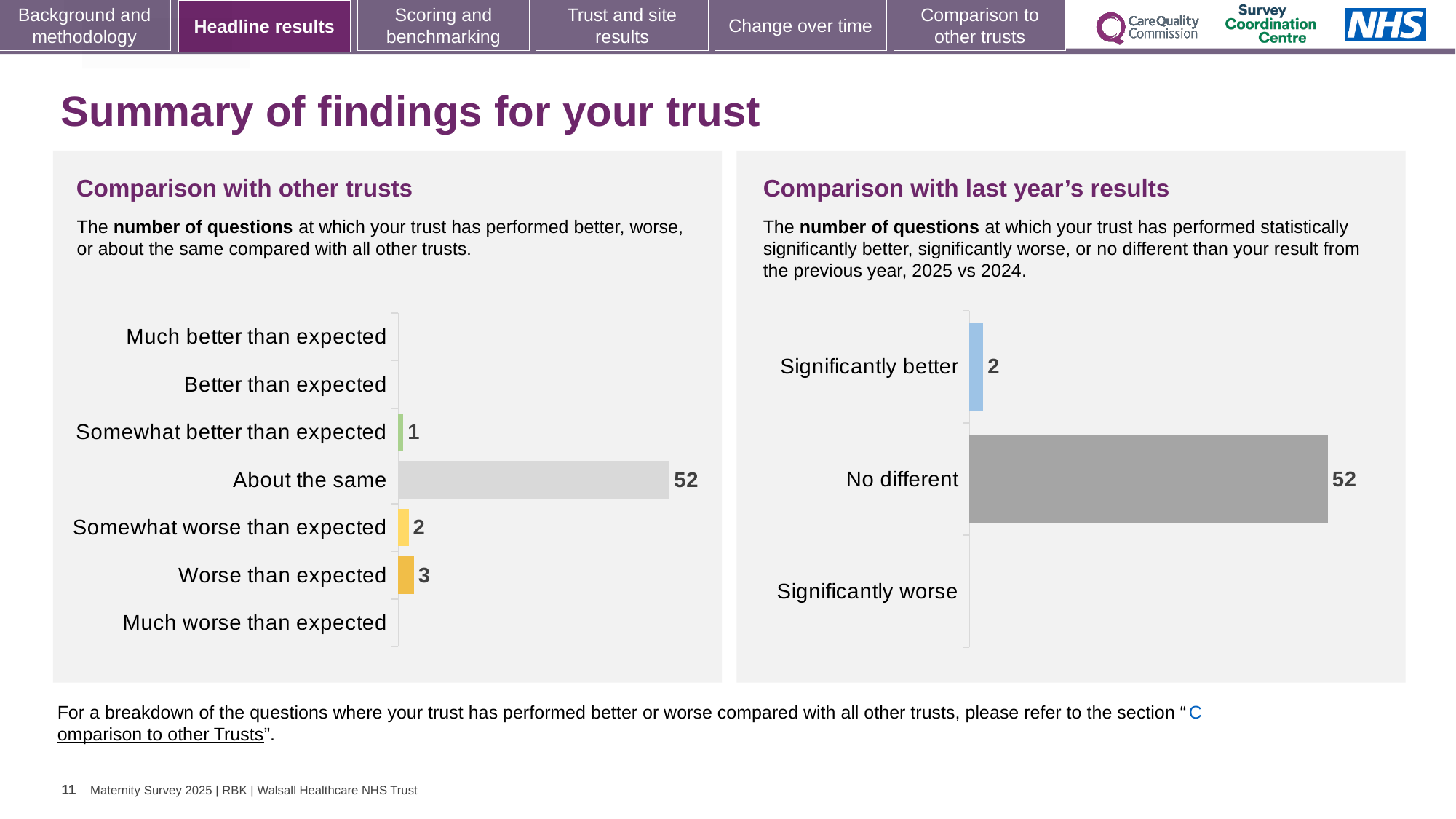
In the 'Comparison with last year's results' chart, what is the value for 'No different'? 52 In the 'Comparison with other trusts' chart, which category has the highest value? About the same In the 'Comparison with other trusts' chart, what is the value for 'Somewhat worse than expected'? 2 In the 'Comparison with other trusts' chart, which is larger: 'Worse than expected' or 'Somewhat worse than expected'? Worse than expected In the 'Comparison with other trusts' chart, what is the value for 'Worse than expected'? 3 In the 'Comparison with other trusts' chart, what is the difference between 'About the same' and 'Worse than expected'? 49 In the 'Comparison with other trusts' chart, what is the value for 'About the same'? 52 In the 'Comparison with last year's results' chart, what is the value for 'Significantly better'? 2 In the 'Comparison with other trusts' chart, what is the value for 'Somewhat better than expected'? 1 What kind of chart is the 'Comparison with last year's results' chart? Bar chart How many categories are listed on the 'Comparison with other trusts' chart? 7 How many categories are listed on the 'Comparison with last year's results' chart? 3